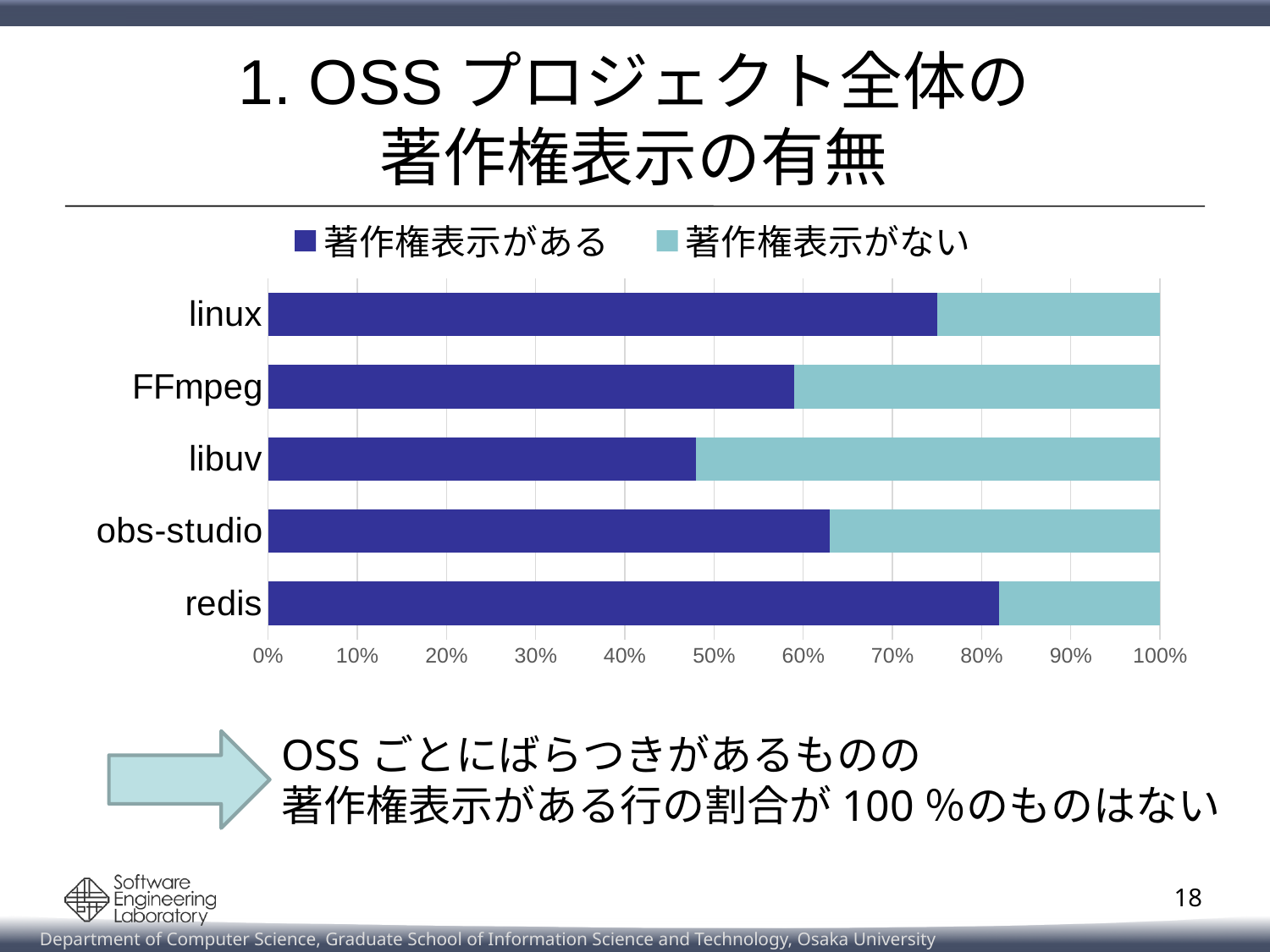
Which project has the larger share of 著作権表示がある, linux or FFmpeg? linux Is the 著作権表示がある share for libuv greater or less than 50%? less Which project has the lowest share of 著作権表示がある? libuv What kind of chart is shown on the slide? Stacked bar chart Which legend entry is shown in dark blue? 著作権表示がある Is the 著作権表示がある share for redis greater or less than 70%? greater Which project has the highest share of 著作権表示がある? redis Which project has the larger share of 著作権表示がない, libuv or obs-studio? libuv What does each stacked bar in the chart total? 100% How many series does the chart legend list? 2 Is the 著作権表示がある share for linux greater or less than 70%? greater How many OSS projects are listed on the vertical axis of the chart? 5